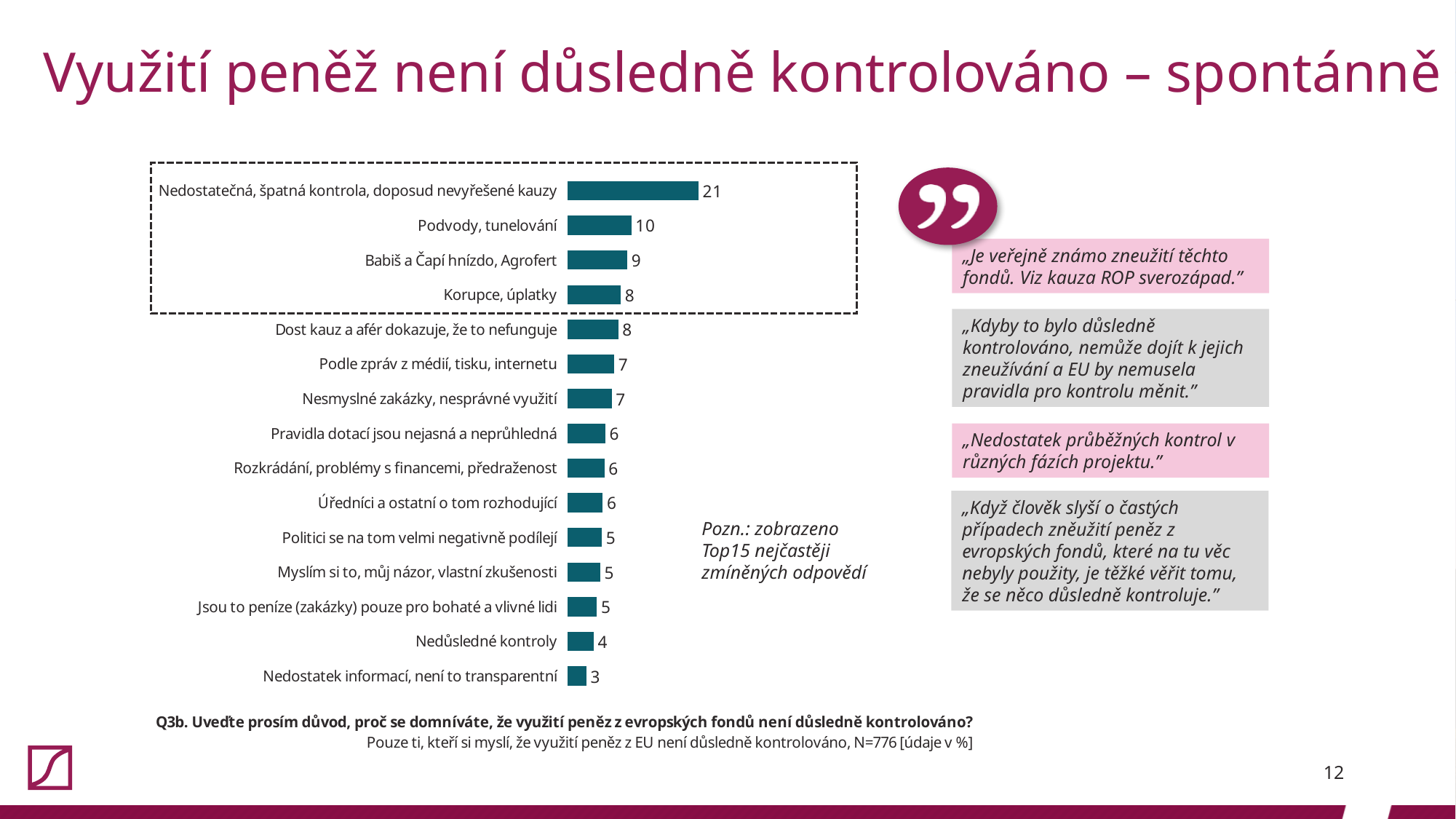
What is the value for "Podvody, tunelování"? 10 What is the difference between the values for "Nedostatečná, špatná kontrola, doposud nevyřešené kauzy" and "Podvody, tunelování"? 11 How many categories are enclosed in the dashed box at the top of the chart? 4 What kind of chart is shown on the slide? Bar chart Which category has the lowest value? Nedostatek informací, není to transparentní What is the value for "Nedůsledné kontroly"? 4 Which category has the highest value? Nedostatečná, špatná kontrola, doposud nevyřešené kauzy Which is larger: the value for "Korupce, úplatky" or the value for "Nedůsledné kontroly"? Korupce, úplatky What is the value for "Nedostatečná, špatná kontrola, doposud nevyřešené kauzy"? 21 What is the difference between the values for "Podle zpráv z médií, tisku, internetu" and "Nedostatek informací, není to transparentní"? 4 What is the value for "Babiš a Čapí hnízdo, Agrofert"? 9 How many categories are shown in the bar chart? 15